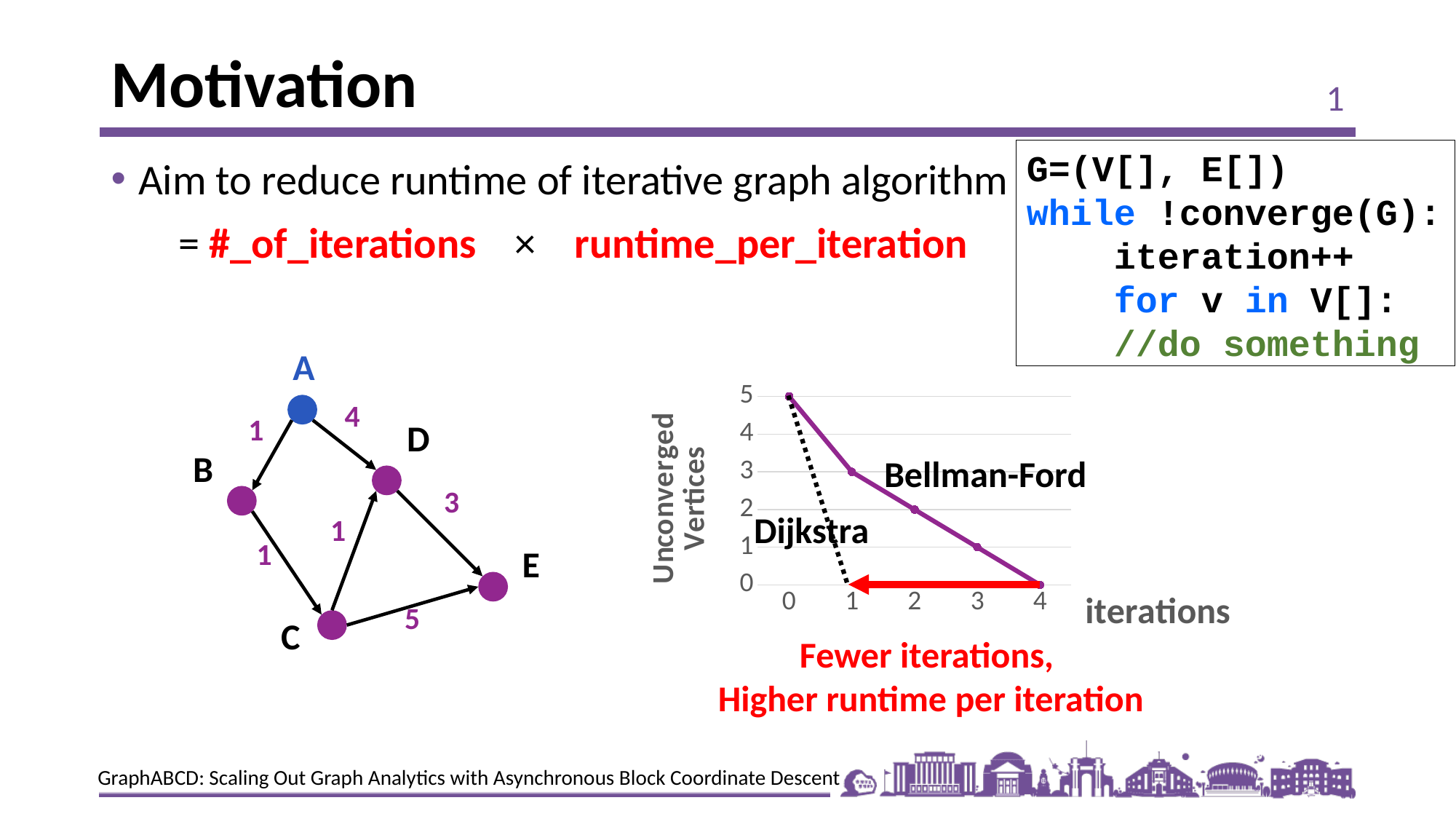
What is the difference in unconverged vertices for Bellman-Ford between iteration 0 and iteration 1? 2 How many unconverged vertices does Bellman-Ford have at iteration 0? 5 At which iteration does Dijkstra reach 0 unconverged vertices? 1 What kind of chart is shown on the slide? line chart At iteration 1, which series has more unconverged vertices, Bellman-Ford or Dijkstra? Bellman-Ford How many unconverged vertices does Bellman-Ford have at iteration 2? 2 Do the unconverged vertices for Bellman-Ford rise or fall as iterations increase? fall What is the label of the y axis of the chart? Unconverged Vertices How many unconverged vertices does Bellman-Ford have at iteration 1? 3 What is the label of the x axis of the chart? iterations At which iteration does Bellman-Ford reach 0 unconverged vertices? 4 How many series are plotted on the chart? 2